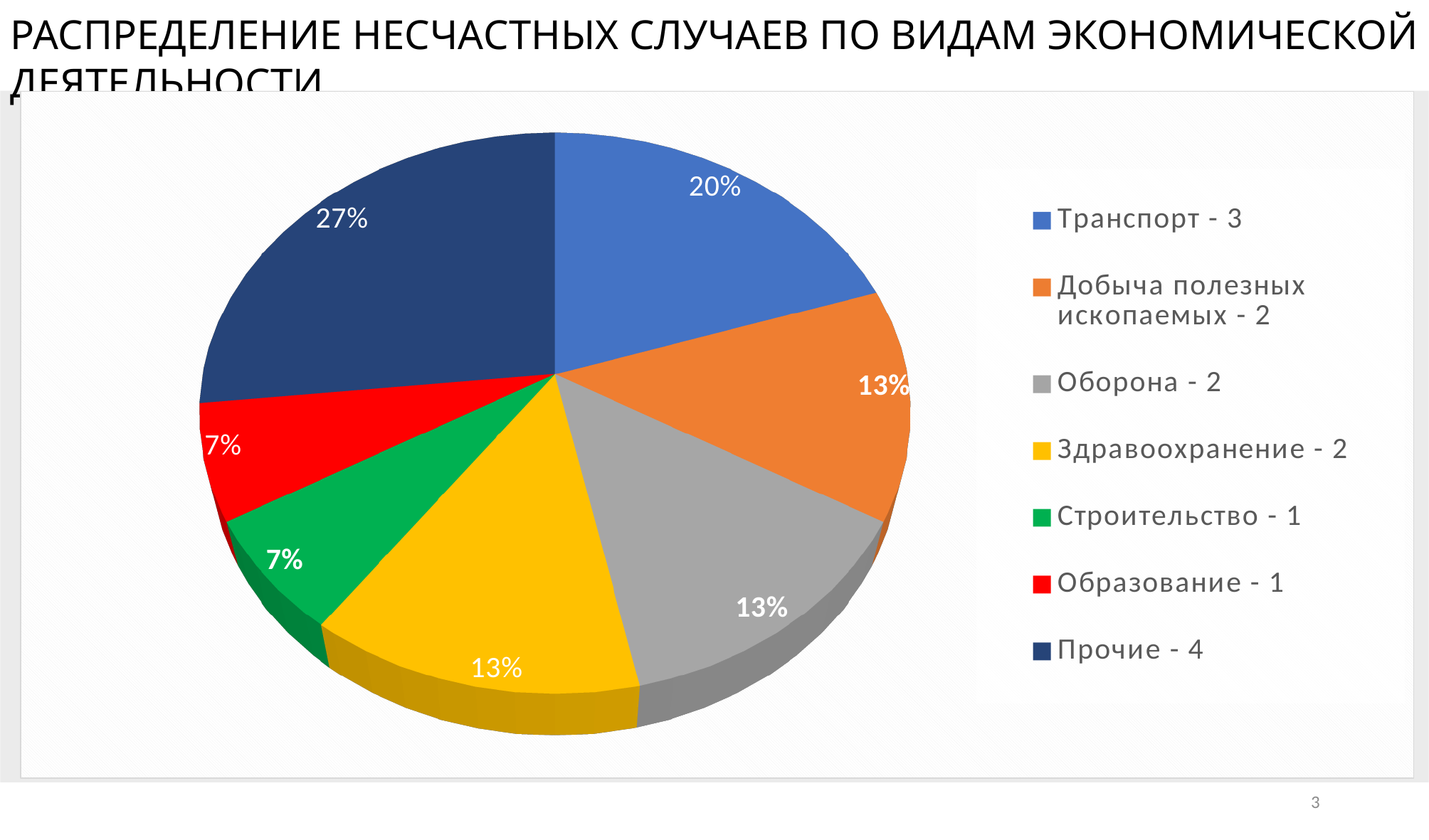
What share of the pie does Транспорт take? 20% What share of the pie does Прочие take? 27% What kind of chart is shown on the slide? pie chart How many accidents does the legend list for Транспорт? 3 Which category has the largest slice of the pie? Прочие What colour is the slice for Здравоохранение? yellow What share of the pie does Образование take? 7% Which is larger, the slice for Транспорт or the slice for Оборона? Транспорт What is the difference in percentage points between the Прочие slice and the Строительство slice? 20 How many slices does the pie chart have? 7 How many accidents does the legend list for Прочие? 4